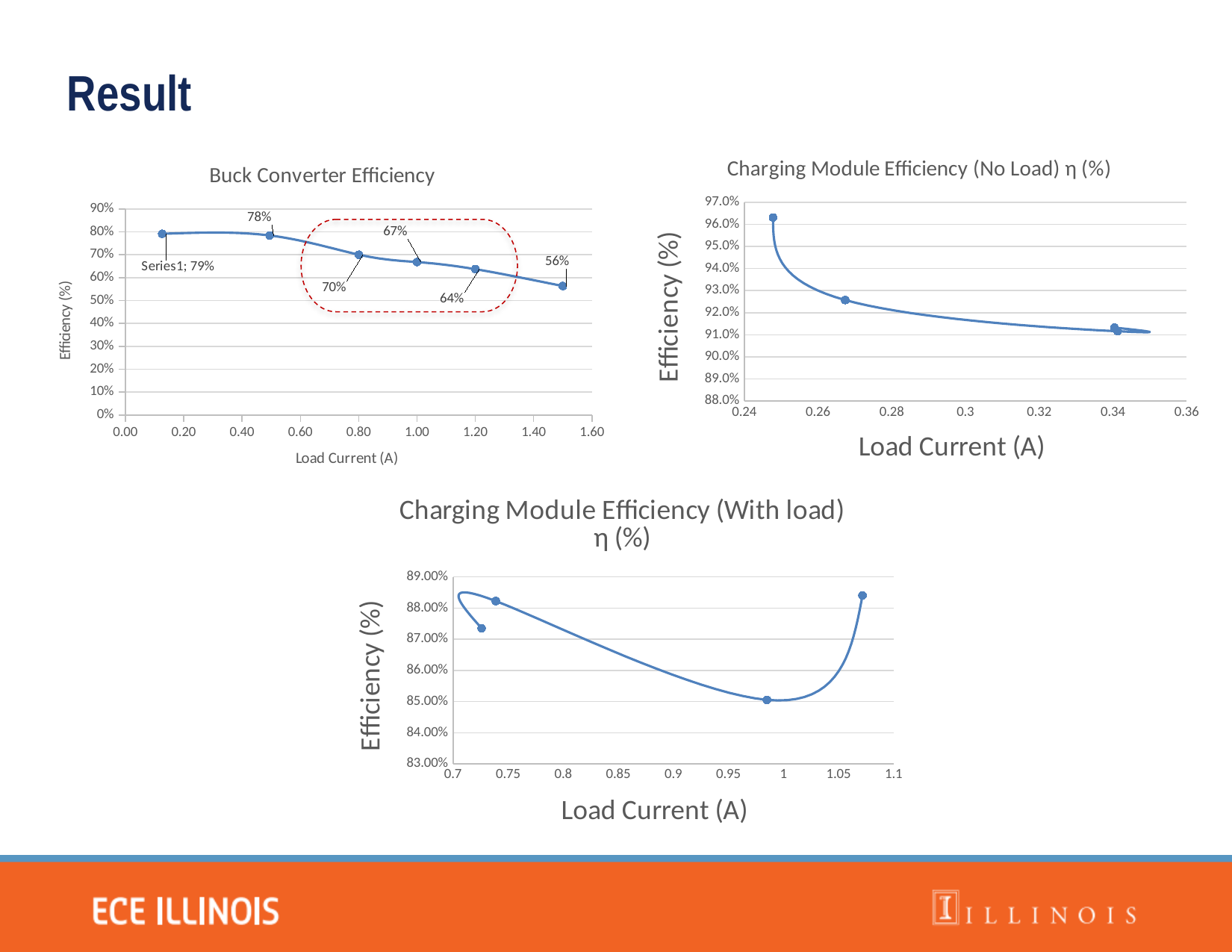
In the Buck Converter Efficiency chart, what is the lowest labeled efficiency value? 56% What is the x-axis label of the Charging Module Efficiency (With load) chart? Load Current (A) In the Charging Module Efficiency (No Load) chart, does efficiency rise or fall as load current increases? fall In the Buck Converter Efficiency chart, what is the difference between the highest labeled efficiency (79%) and the lowest (56%)? 23 percentage points In the Buck Converter Efficiency chart, what is the highest labeled efficiency value? 79% In the Buck Converter Efficiency chart, what is the efficiency at a load current of 0.50 A? 78% In the Charging Module Efficiency (With load) chart, is the efficiency at the point near 1 A greater or less than 86.00%? less In the Buck Converter Efficiency chart, how many data points are plotted? 6 In the Buck Converter Efficiency chart, which is larger: the efficiency at 0.80 A or at 1.20 A? 0.80 A (70%) In the Buck Converter Efficiency chart, what is the efficiency at a load current of 1.00 A? 67% In the Charging Module Efficiency (No Load) chart, is the efficiency at the lowest load current (about 0.25 A) greater or less than 96.0%? greater In the Buck Converter Efficiency chart, does efficiency rise or fall as load current increases? fall